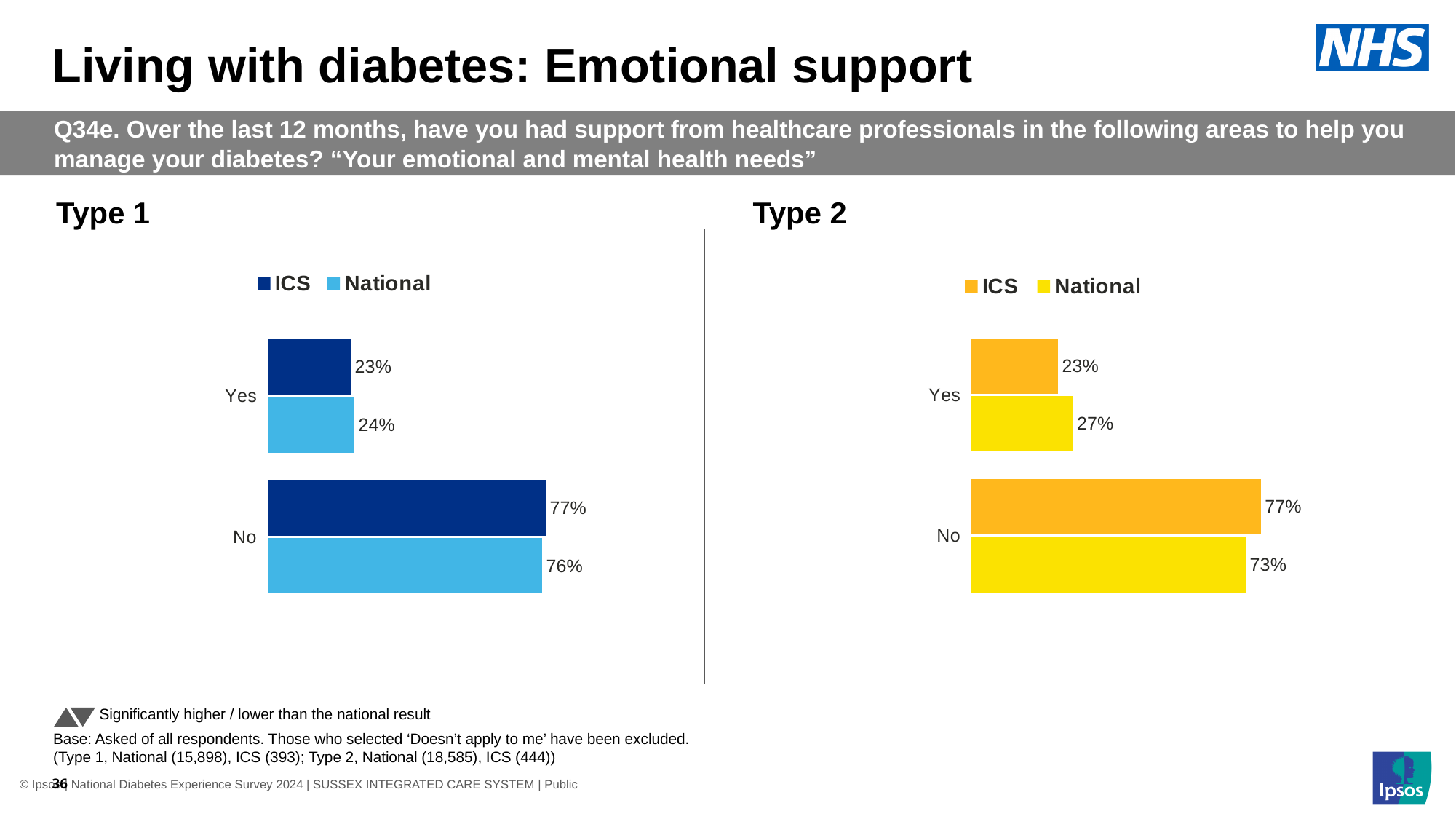
In the Type 1 chart, what is the ICS value for Yes? 23% In the Type 2 chart, which is larger for Yes: ICS or National? National What are the two series named in the legend of the Type 1 chart? ICS and National In the Type 1 chart, which category has the highest ICS value? No In the Type 1 chart, what is the National value for No? 76% In the Type 2 chart, what is the ICS value for No? 77% What kind of chart is the Type 1 chart? Bar chart How many categories are shown in the Type 1 chart? 2 How many series does the legend of the Type 2 chart list? 2 In the Type 2 chart, what is the National value for Yes? 27% In the Type 2 chart, what is the difference between the National and ICS values for Yes? 4 percentage points In the Type 2 chart, what is the difference between the ICS and National values for No? 4 percentage points